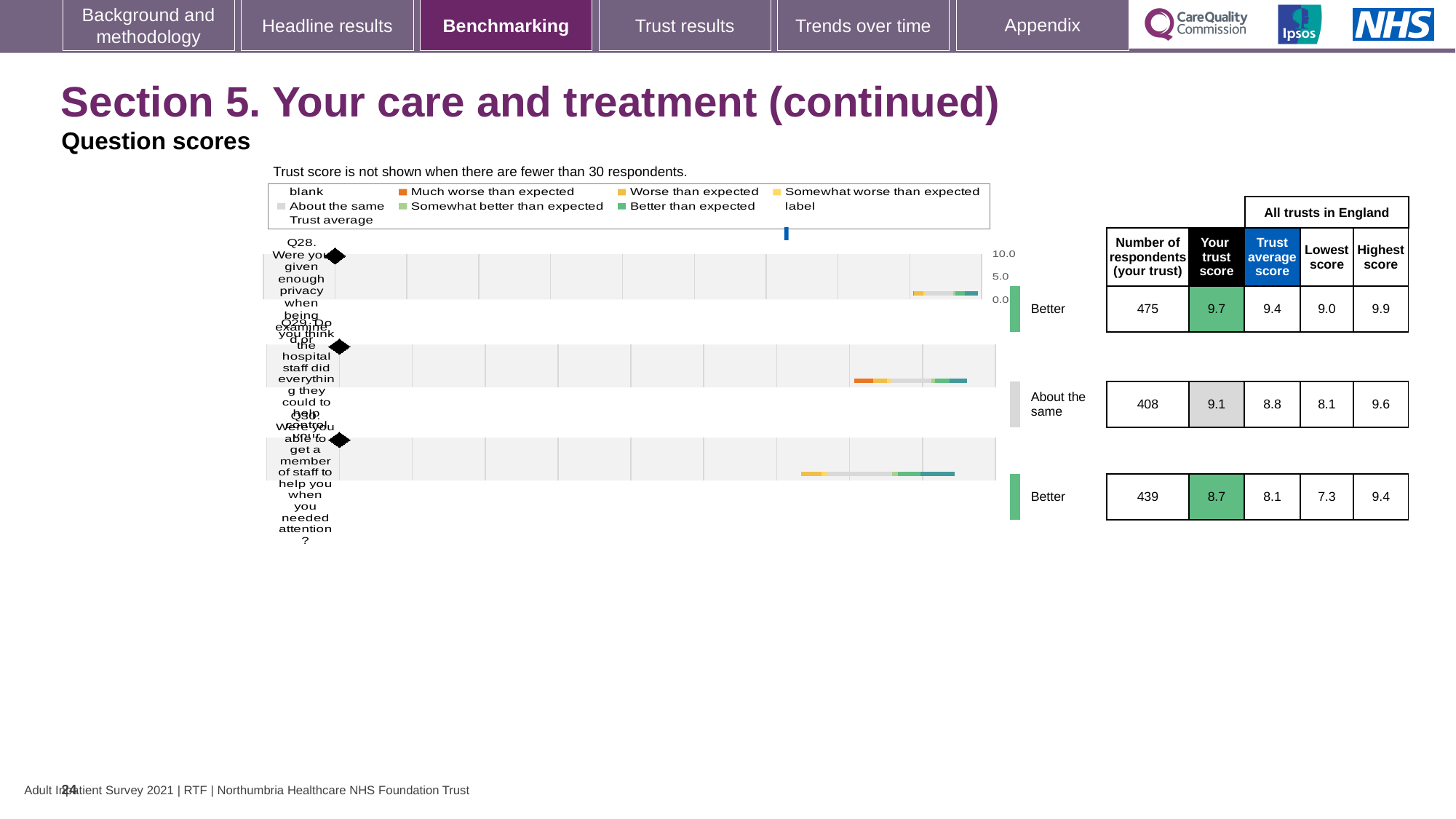
What is the difference between the trust score and the trust average score for Q28? 0.3 What is the highest score among all trusts in England for Q30? 9.4 What is the trust score for Q28 (Were you given enough privacy when being examined or treated?)? 9.7 What is the trust average score for Q30 (Were you able to get a member of staff to help you when you needed attention?)? 8.1 What benchmark category is shown next to the Q29 chart? About the same For Q29, which is larger: the trust score or the trust average score? the trust score (9.1) What kind of chart is used to show the question scores for Q28, Q29 and Q30? bar chart How many questions (Q28, Q29, Q30) are plotted on the slide? 3 Which question has the highest 'Your trust score'? Q28 Which question has the lowest 'Your trust score'? Q30 How many respondents does the table show for Q29 (Do you think the hospital staff did everything they could to help control your pain?)? 408 What is the maximum value shown on the chart's score axis? 10.0